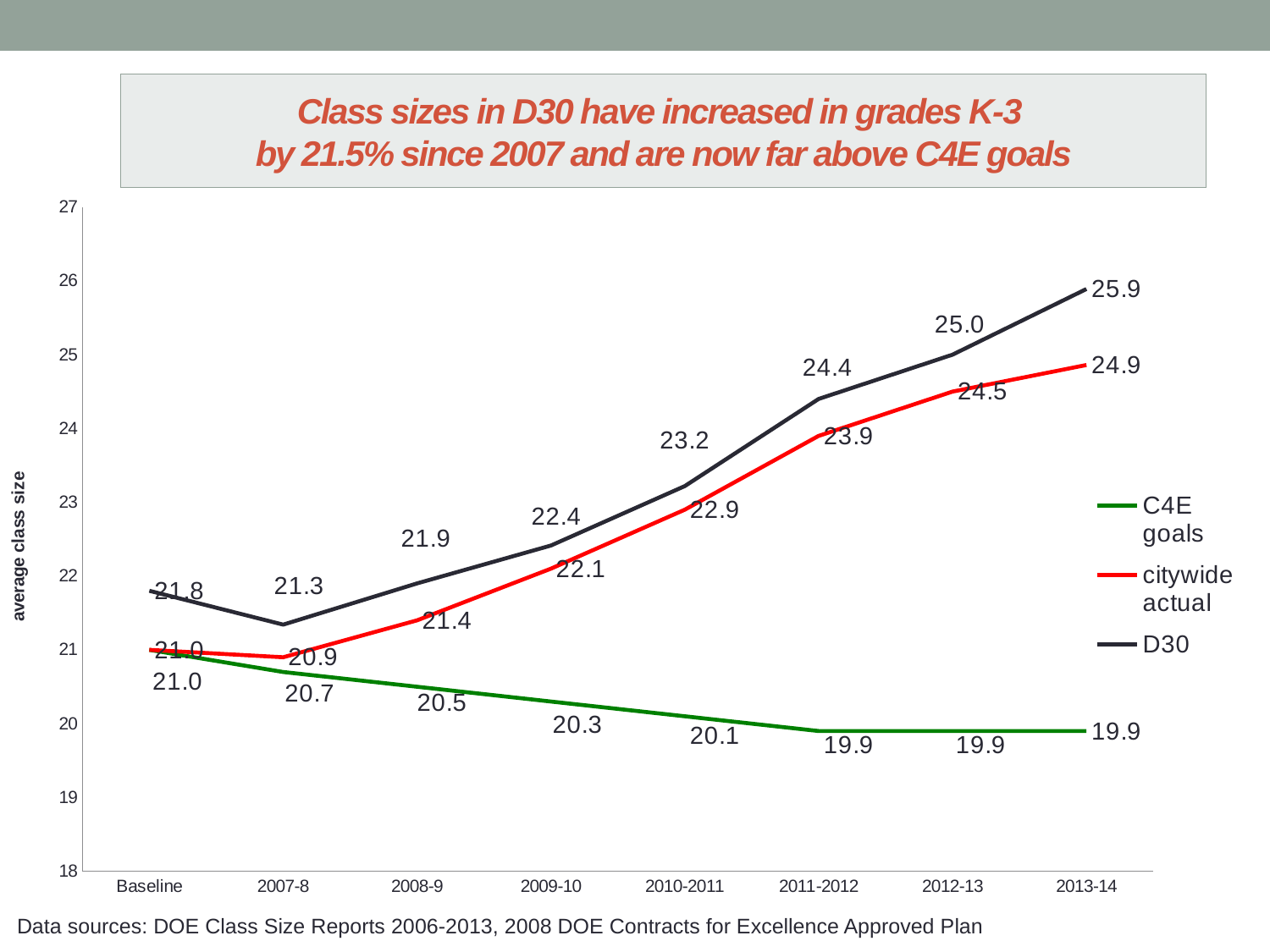
In which year does the D30 series reach its highest value? 2013-14 How many points are plotted along the x axis for each series? 8 What is the D30 value for 2013-14? 25.9 What is the citywide actual value for 2011-2012? 23.9 What kind of chart is shown on the slide? Line chart In which year is the D30 series at its lowest value? 2007-8 How many series does the legend list? 3 What is the D30 value at Baseline? 21.8 Does the C4E goals series rise or fall from Baseline to 2013-14? Fall Which is larger in 2012-13, the D30 value or the citywide actual value? D30 What is the C4E goals value for 2009-10? 20.3 What is the difference between the D30 value and the C4E goals value in 2013-14? 6.0